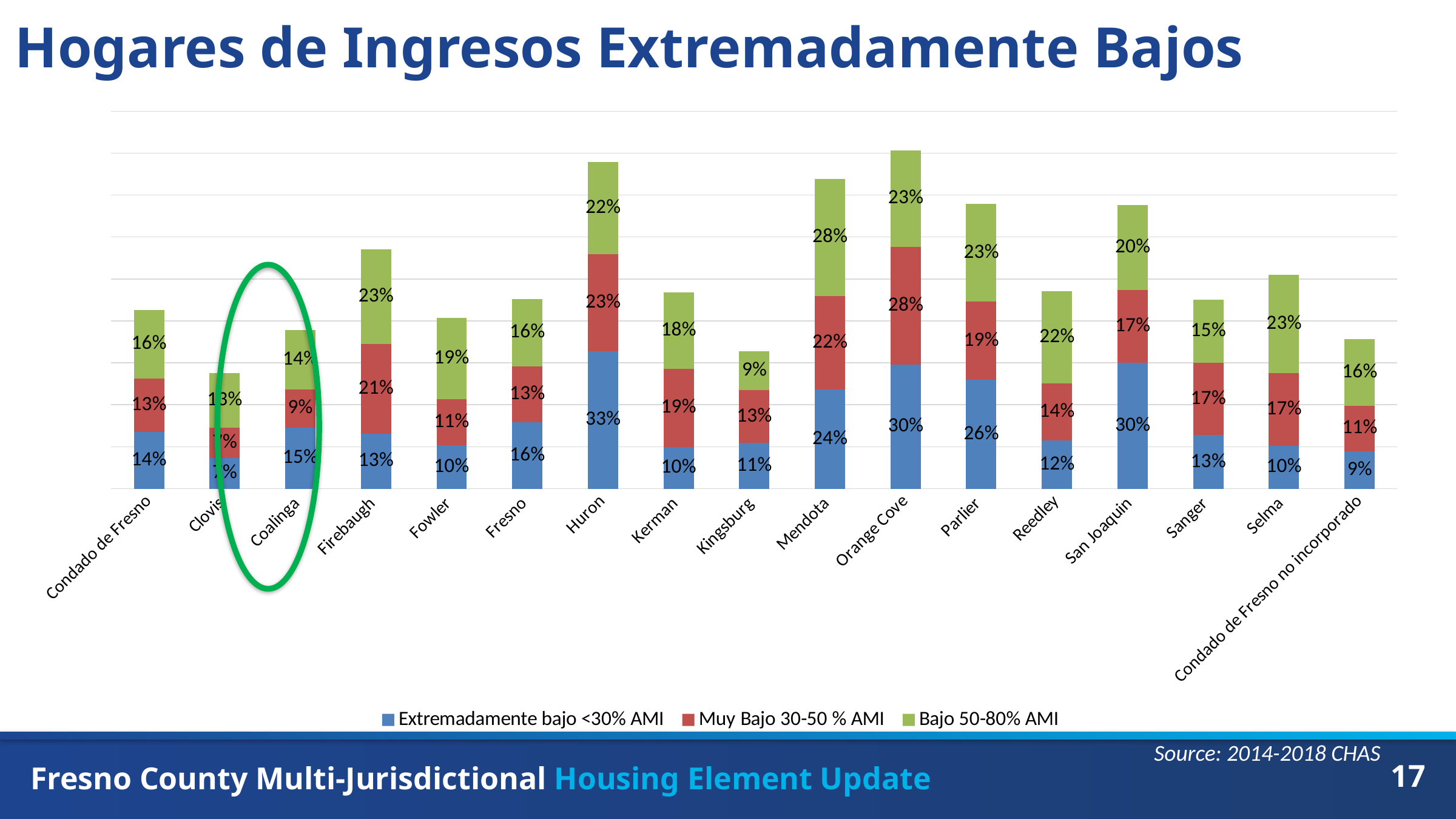
Which category is circled in green on the chart? Coalinga What is the total of the stacked bar for Coalinga? 38% What is the value of Bajo 50-80% AMI for Mendota? 28% Which category has the highest value for Extremadamente bajo <30% AMI? Huron What is the difference between the Extremadamente bajo <30% AMI values for Orange Cove and Reedley? 18% How many categories are shown on the x axis? 17 What type of chart is shown on the slide? Stacked bar chart Which is larger, the Muy Bajo 30-50 % AMI value for Firebaugh or for Fowler? Firebaugh What is the value of Extremadamente bajo <30% AMI for Huron? 33% Which category has the lowest value for Bajo 50-80% AMI? Kingsburg How many series does the legend list? 3 What is the value of Muy Bajo 30-50 % AMI for Coalinga? 9%